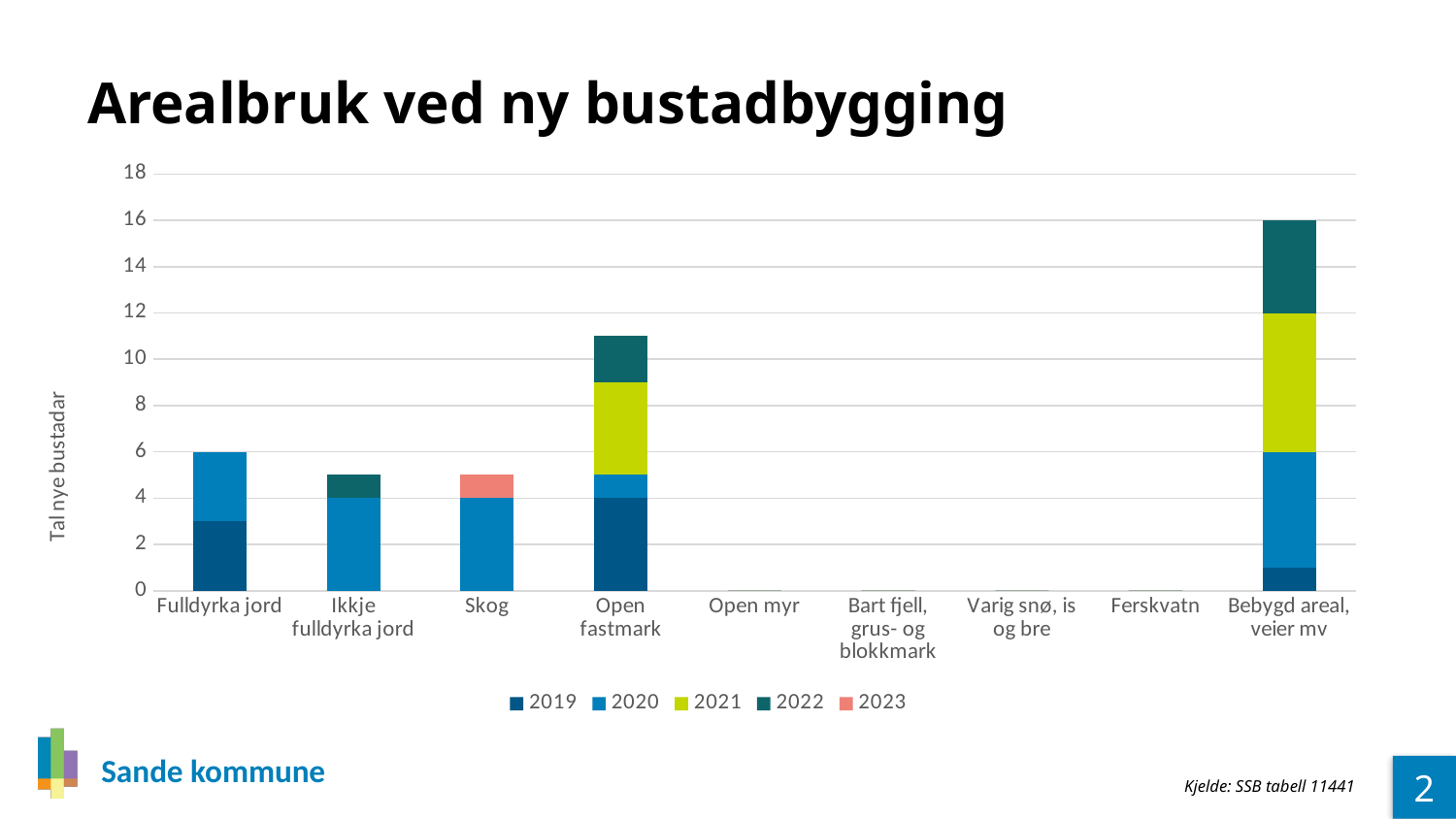
What is the total height of the stacked bar for Bebygd areal, veier mv? 16 How many categories are shown on the x axis? 9 How many series does the legend list? 5 Which year in the legend is shown in salmon/pink? 2023 What is the title of the chart? Arealbruk ved ny bustadbygging Which category has the tallest stacked bar? Bebygd areal, veier mv Is the total for Skog greater or less than 6? less What is the value of the 2019 segment for Open fastmark? 4 What type of chart is shown on the slide? Stacked bar chart What is the total height of the stacked bar for Fulldyrka jord? 6 Is the total for Open fastmark greater or less than 10? greater Which has a taller stacked bar, Open fastmark or Fulldyrka jord? Open fastmark